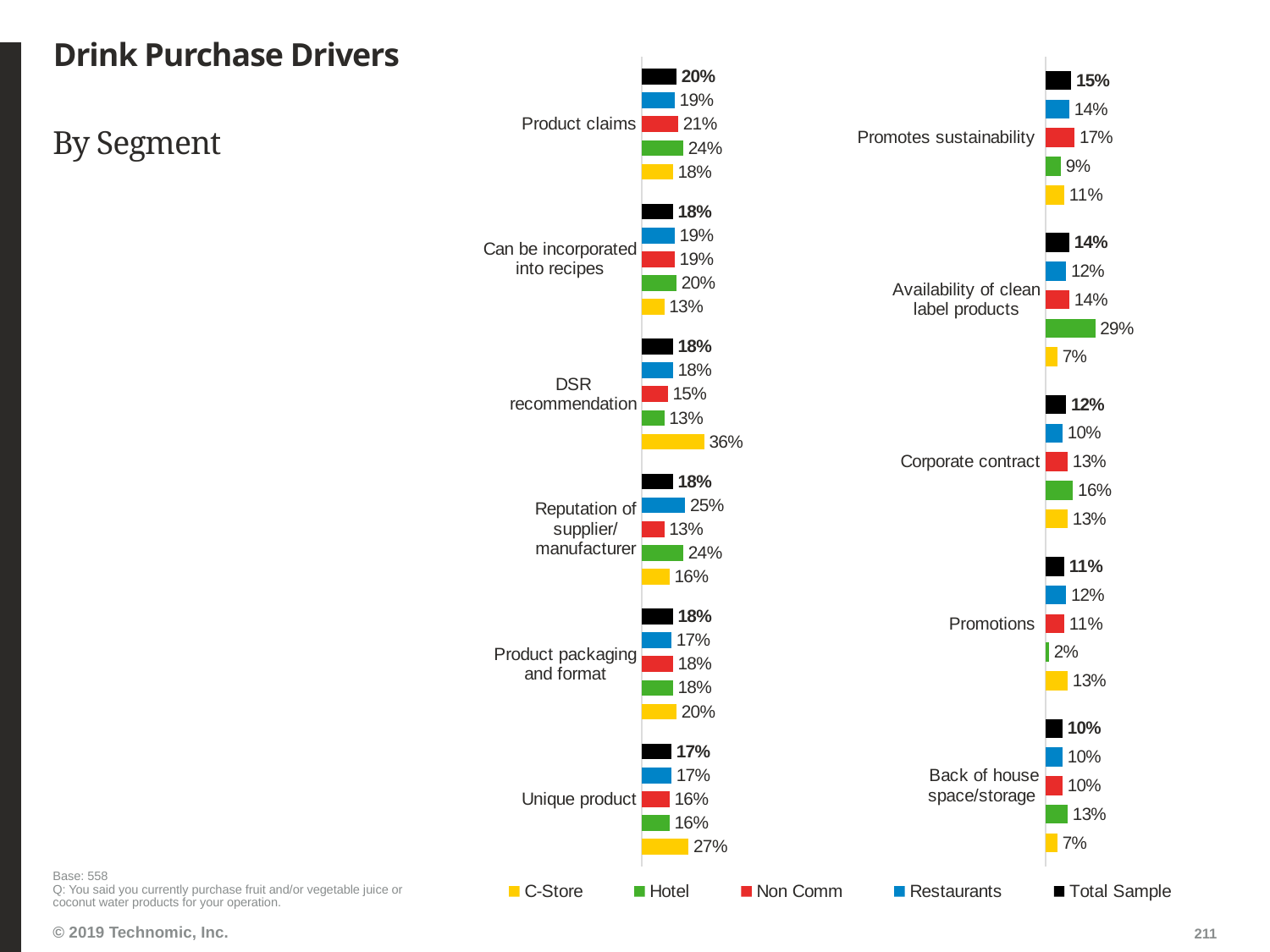
How many categories are shown on the left chart? 6 How many categories are shown on the right chart? 5 On the right chart, what is the Hotel value for Promotions? 2% What type of chart is used on this slide? Bar chart On the left chart, what is the difference between the Hotel and C-Store values for Product claims? 6% On the left chart, what is the Restaurants value for Reputation of supplier/manufacturer? 25% On the left chart, what is the C-Store value for DSR recommendation? 36% On the left chart, which segment has the highest value for Unique product? C-Store On the right chart, which segment has the lowest value for Back of house space/storage? C-Store On the right chart, which is larger for Promotes sustainability: the Non Comm value or the Hotel value? Non Comm How many series does the legend list? 5 On the right chart, what is the Hotel value for Availability of clean label products? 29%